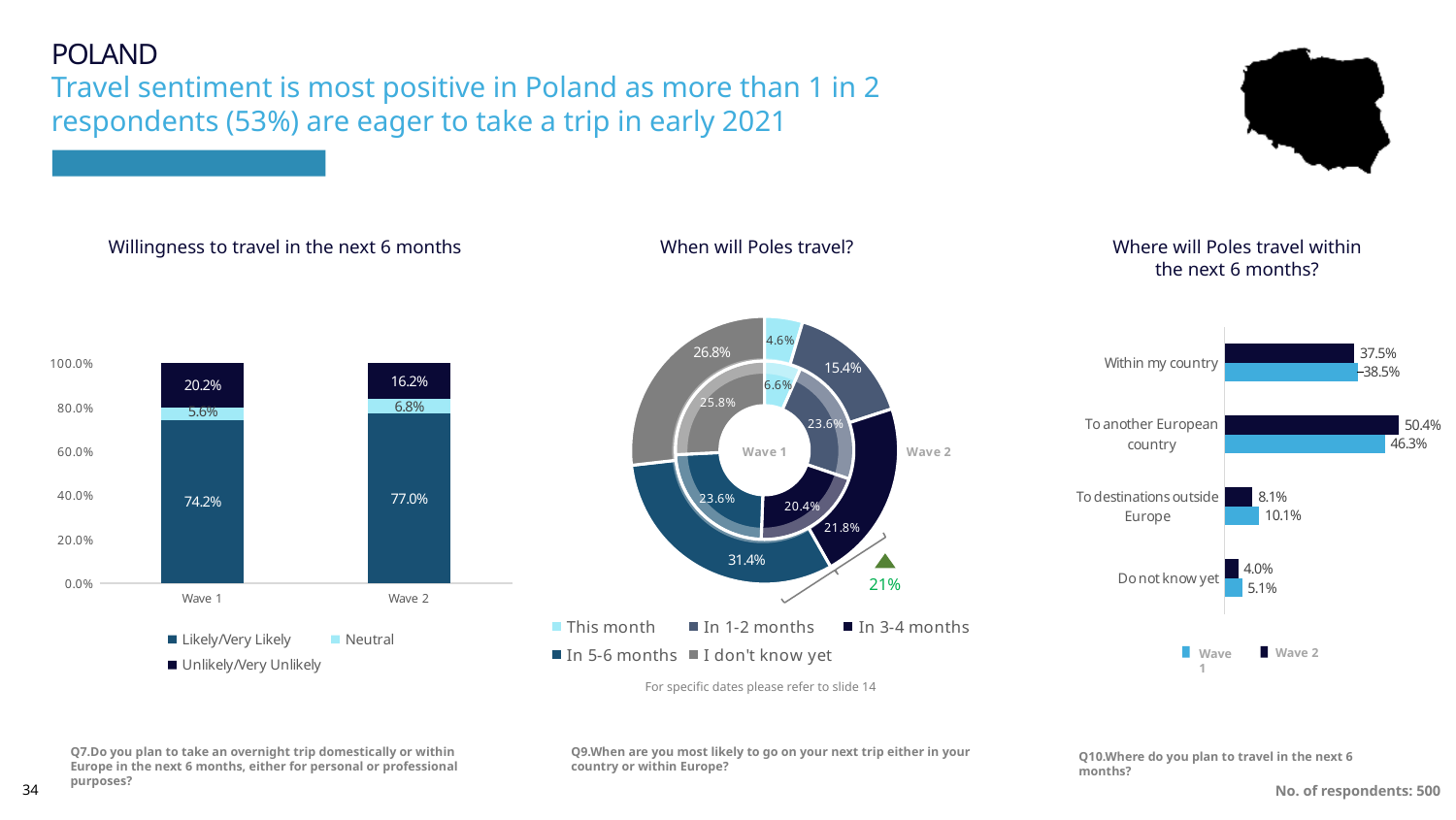
In the 'When will Poles travel?' chart, which category has the largest Wave 2 share? In 5-6 months In the 'Willingness to travel in the next 6 months' chart, what is the Likely/Very Likely value for Wave 2? 77.0% In the 'Willingness to travel in the next 6 months' chart, what is the Unlikely/Very Unlikely value for Wave 1? 20.2% In the 'When will Poles travel?' chart, what is the Wave 2 share for 'In 5-6 months'? 31.4% In the 'Where will Poles travel within the next 6 months?' chart, what is the Wave 2 value for 'To another European country'? 50.4% In the 'When will Poles travel?' chart, how many categories does the legend list? 5 What kind of chart is 'Willingness to travel in the next 6 months'? Stacked bar chart In the 'When will Poles travel?' chart, what is the Wave 1 share for 'This month'? 6.6% In the 'Where will Poles travel within the next 6 months?' chart, which destination has the lowest Wave 2 value? Do not know yet In the 'Willingness to travel in the next 6 months' chart, what is the difference between the Likely/Very Likely values for Wave 2 and Wave 1? 2.8% In the 'Where will Poles travel within the next 6 months?' chart, which is larger for 'Within my country': Wave 1 or Wave 2? Wave 1 In the 'Willingness to travel in the next 6 months' chart, how many series does the legend list? 3